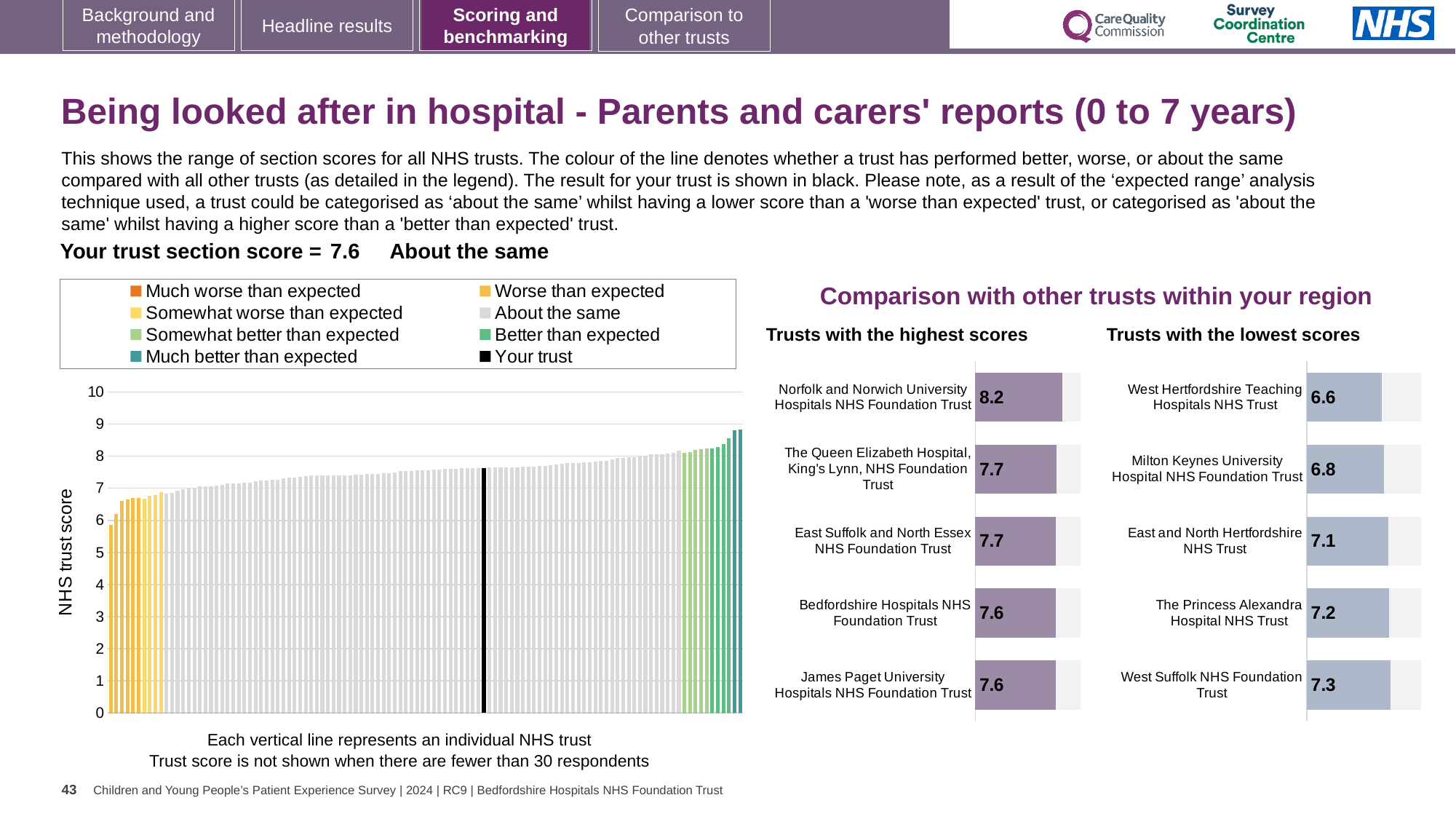
What kind of chart is the main chart showing all NHS trusts? bar chart In the 'Trusts with the lowest scores' chart, which trust has the lowest score? West Hertfordshire Teaching Hospitals NHS Trust How many trusts are listed in the 'Trusts with the highest scores' chart? 5 In the main chart of all NHS trusts, what is the section score for your trust (the black line)? 7.6 In the 'Trusts with the highest scores' chart, which trust has the highest score? Norfolk and Norwich University Hospitals NHS Foundation Trust How many entries does the legend of the main chart list? 8 In the 'Trusts with the highest scores' chart, what is the difference between the scores of Norfolk and Norwich University Hospitals NHS Foundation Trust and Bedfordshire Hospitals NHS Foundation Trust? 0.6 In the 'Trusts with the highest scores' chart, what is the score for Norfolk and Norwich University Hospitals NHS Foundation Trust? 8.2 In the main chart of all NHS trusts, do the trust scores rise or fall from left to right? rise In the 'Trusts with the lowest scores' chart, what is the score for Milton Keynes University Hospital NHS Foundation Trust? 6.8 In the 'Trusts with the lowest scores' chart, which has the higher score: East and North Hertfordshire NHS Trust or The Princess Alexandra Hospital NHS Trust? The Princess Alexandra Hospital NHS Trust In the 'Trusts with the lowest scores' chart, what is the difference between the scores of West Suffolk NHS Foundation Trust and West Hertfordshire Teaching Hospitals NHS Trust? 0.7